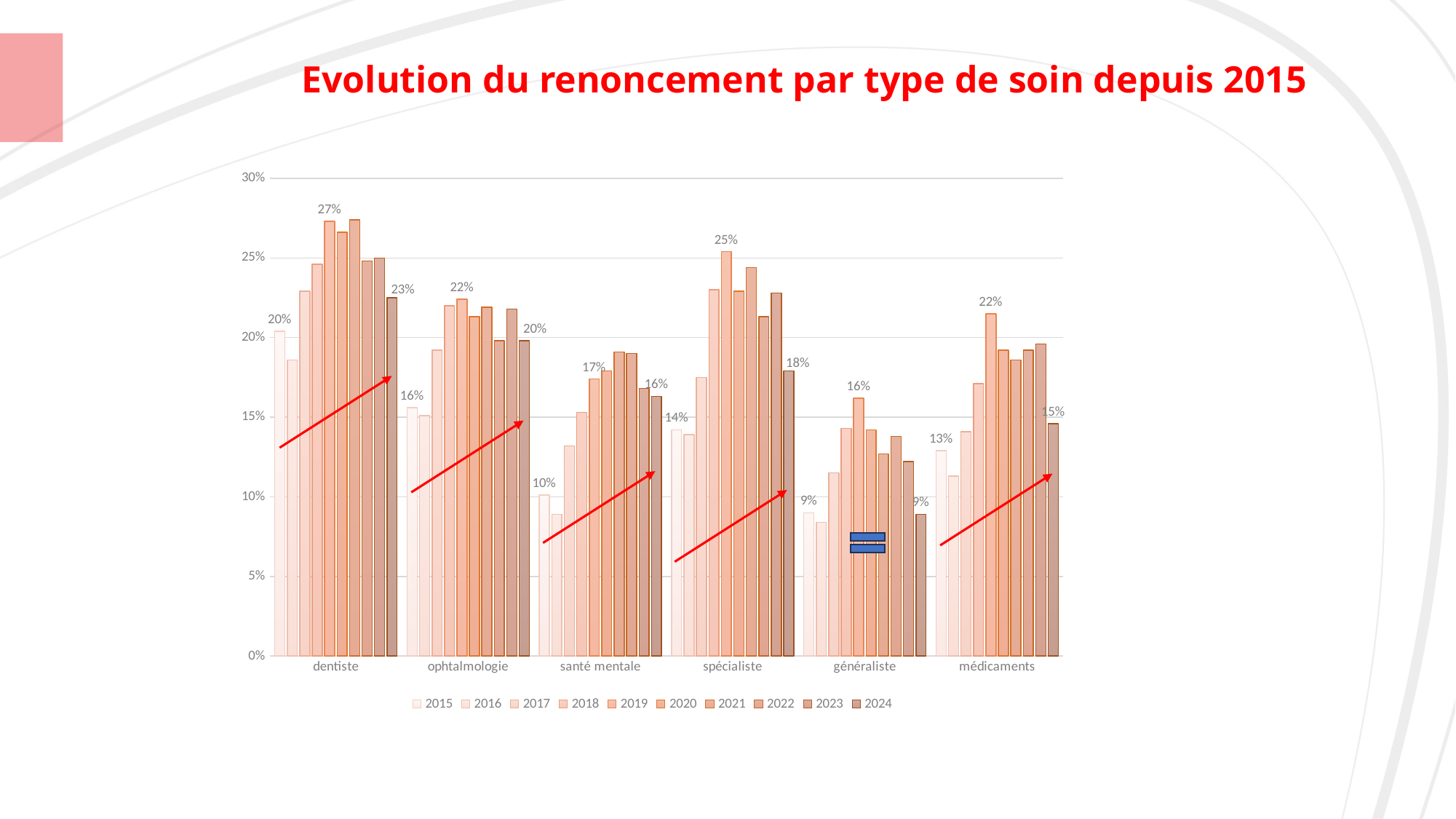
What is the value for généraliste in 2024? 9% Which category has the highest value in 2015? dentiste What kind of chart is shown on the slide? bar chart Which is larger in 2015: the value for dentiste or the value for généraliste? dentiste How many series does the legend list? 10 What is the value for ophtalmologie in 2015? 16% How many care-type categories are shown on the x axis? 6 Is the value for médicaments in 2016 greater or less than 15%? less What is the value for dentiste in 2024? 23% By how many percentage points did santé mentale change between 2015 (10%) and 2024 (16%)? 6 percentage points What is the value for dentiste in 2015? 20% Which category has the lowest value in 2024? généraliste